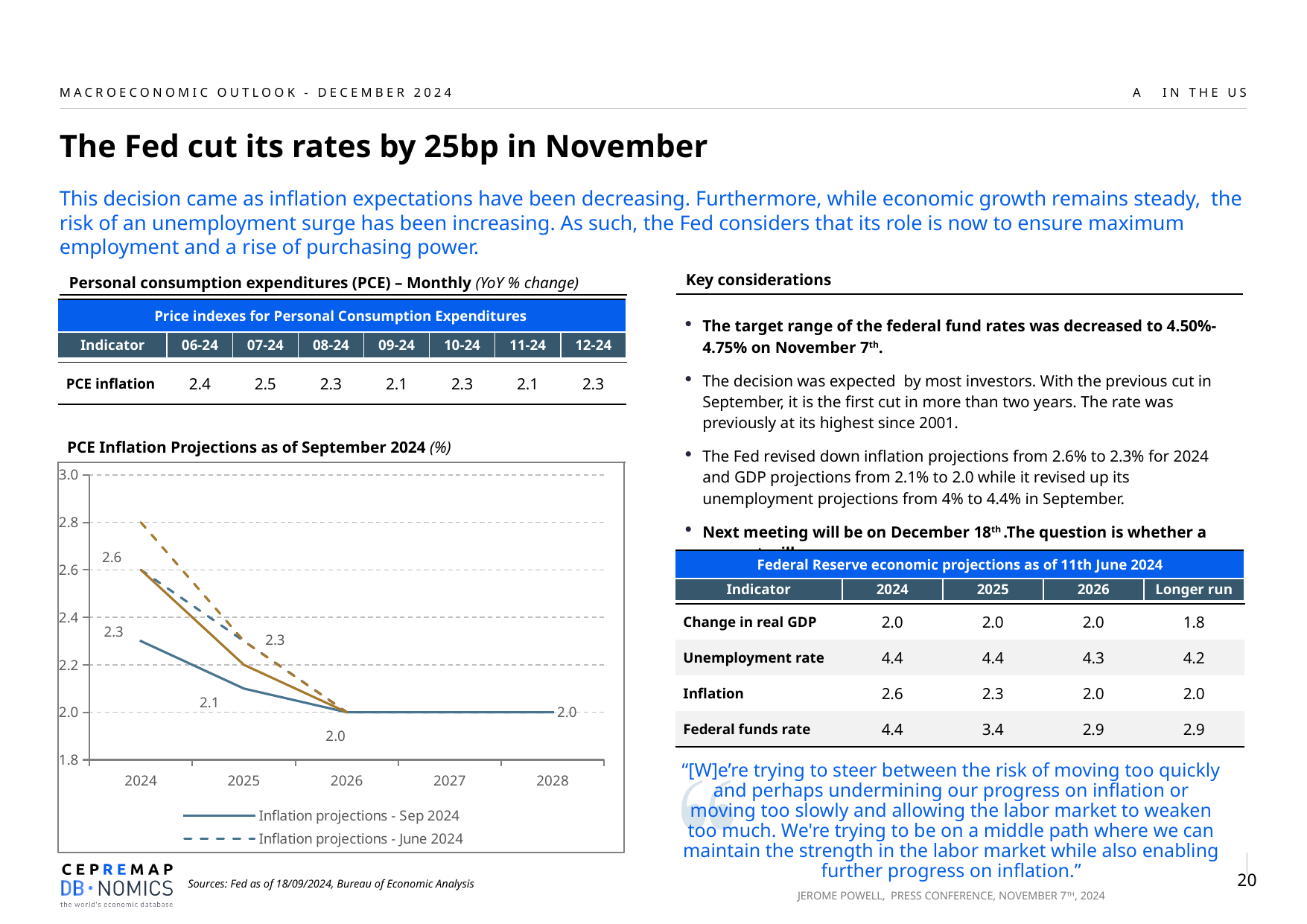
In the PCE Inflation Projections chart, what is the difference between the June 2024 and September 2024 projections for 2024? 0.3 How many years are shown on the x axis of the PCE Inflation Projections chart? 5 In the PCE Inflation Projections chart, what is the value of the 'Inflation projections - June 2024' series for 2024? 2.6 In the PCE Inflation Projections chart, do the 'Inflation projections - Sep 2024' values rise or fall from 2024 to 2026? fall In the PCE Inflation Projections chart, what is the value of the 'Inflation projections - Sep 2024' series for 2024? 2.3 In the PCE Inflation Projections chart, is the 'Inflation projections - June 2024' value for 2024 greater or less than 2.4? greater What kind of chart is the 'PCE Inflation Projections as of September 2024' chart? line chart What is the title of the line chart on the slide? PCE Inflation Projections as of September 2024 (%) In the PCE Inflation Projections chart, which series has the higher value for 2024, 'Inflation projections - Sep 2024' or 'Inflation projections - June 2024'? Inflation projections - June 2024 In the PCE Inflation Projections chart, what is the value of the 'Inflation projections - Sep 2024' series for 2025? 2.1 How many series does the legend of the PCE Inflation Projections chart list? 2 In the PCE Inflation Projections chart, what is the value of the 'Inflation projections - Sep 2024' series for 2028? 2.0